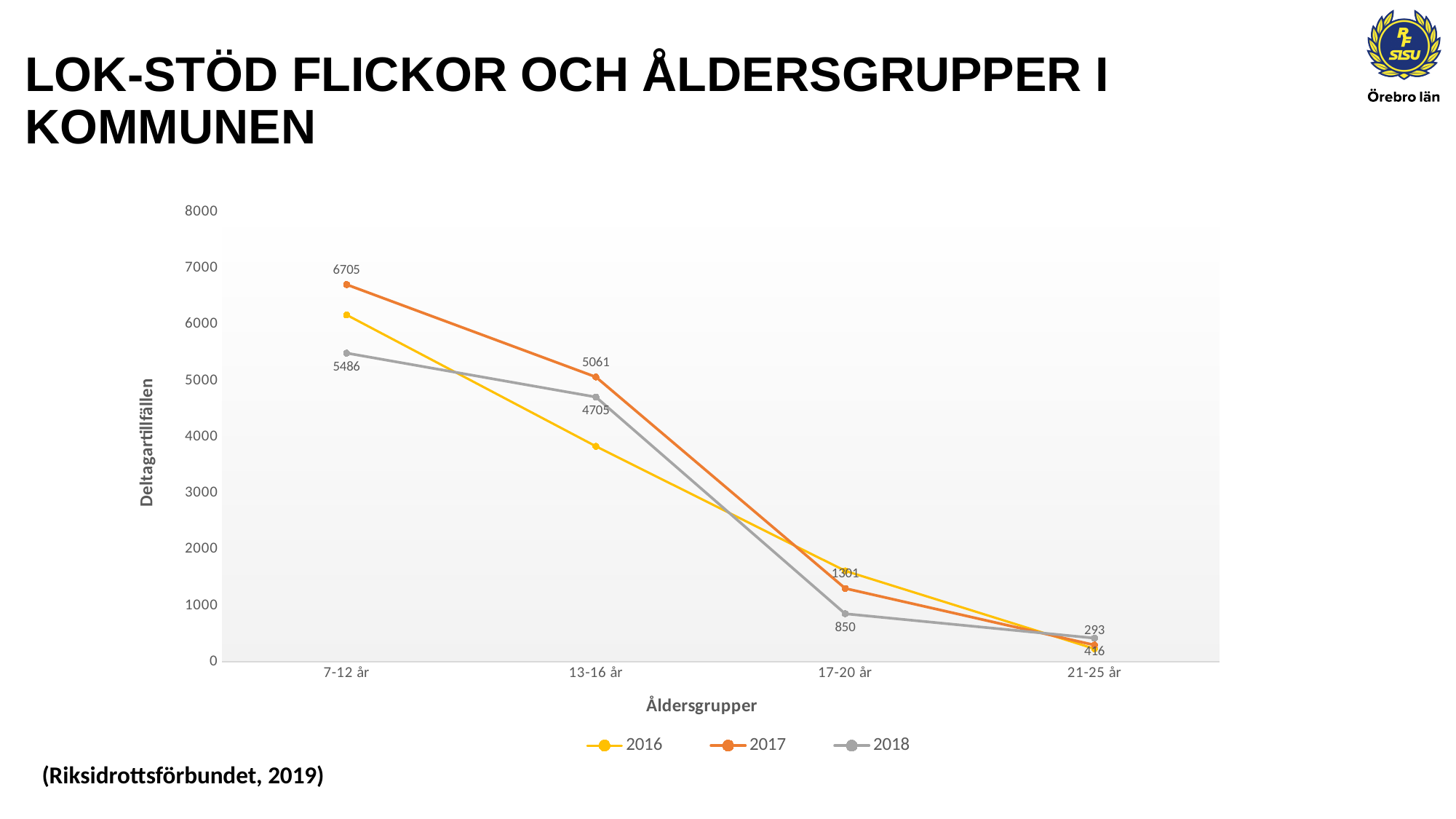
How many series does the legend list? 3 What is the difference between the 2017 and 2018 values at 7-12 år? 1219 What is the value for 2018 at 13-16 år? 4705 What is the value for 2017 at 13-16 år? 5061 For 2017, how much higher is the value at 13-16 år than at 17-20 år? 3760 At 13-16 år, which series has the larger value, 2017 or 2018? 2017 What kind of chart is shown on the slide? line chart What is the value for 2017 at 7-12 år? 6705 Which age group has the highest value for 2017? 7-12 år Is the value for 2016 at 13-16 år greater or less than 4000? less How many age groups are shown on the x axis? 4 What is the value for 2018 at 17-20 år? 850